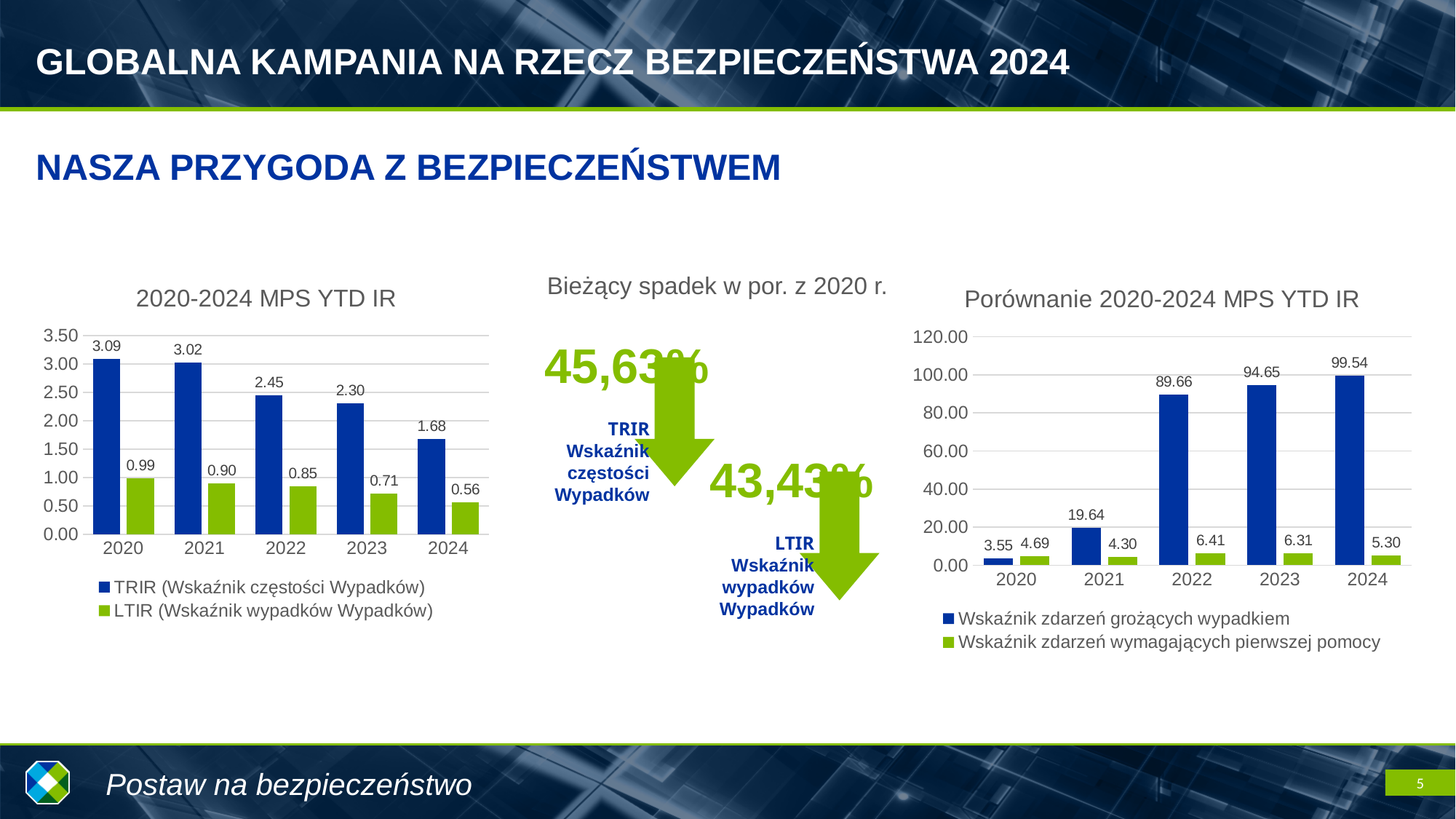
In the chart titled "2020-2024 MPS YTD IR", which year has the highest TRIR value? 2020 In the chart titled "Porównanie 2020-2024 MPS YTD IR", which year has the lowest value of Wskaźnik zdarzeń grożących wypadkiem? 2020 In the chart titled "Porównanie 2020-2024 MPS YTD IR", what is the value of Wskaźnik zdarzeń wymagających pierwszej pomocy for 2022? 6.41 In the chart titled "2020-2024 MPS YTD IR", what is the difference between the TRIR values for 2020 and 2024? 1.41 In the chart titled "2020-2024 MPS YTD IR", what is the TRIR value for 2022? 2.45 In the chart titled "Porównanie 2020-2024 MPS YTD IR", what is the value of Wskaźnik zdarzeń grożących wypadkiem for 2024? 99.54 What kind of chart is the one titled "Porównanie 2020-2024 MPS YTD IR"? bar chart In the chart titled "Porównanie 2020-2024 MPS YTD IR", which is larger in 2020: Wskaźnik zdarzeń grożących wypadkiem or Wskaźnik zdarzeń wymagających pierwszej pomocy? Wskaźnik zdarzeń wymagających pierwszej pomocy In the chart titled "2020-2024 MPS YTD IR", what is the LTIR value for 2024? 0.56 In the chart titled "2020-2024 MPS YTD IR", do the TRIR values rise or fall from 2020 to 2024? fall In the chart titled "Porównanie 2020-2024 MPS YTD IR", how many years are shown on the x axis? 5 In the chart titled "2020-2024 MPS YTD IR", how many series does the legend list? 2